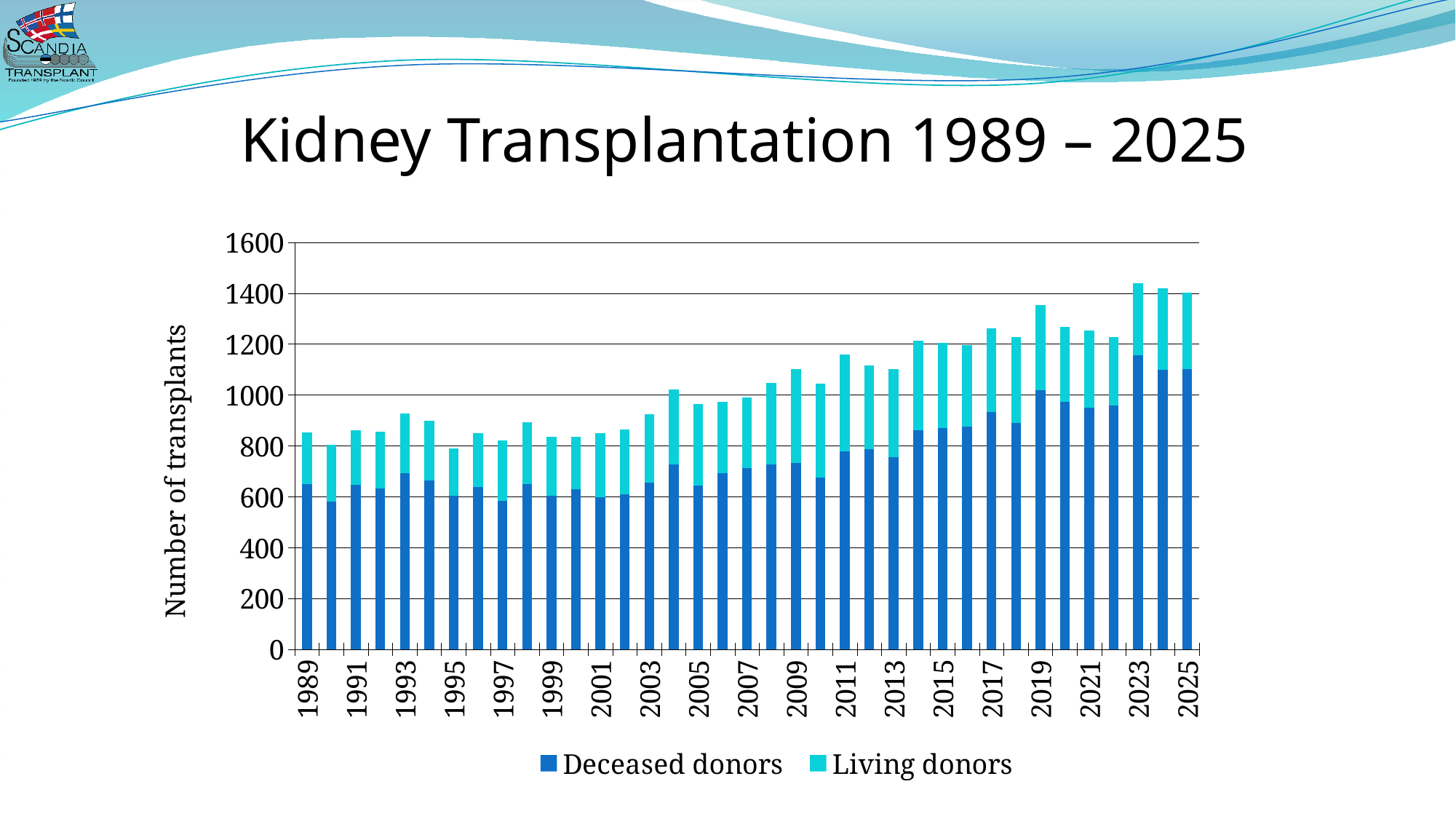
How many series does the legend list? 2 Is the Deceased donors value for 1995 greater or less than 800? less How many years (bars) are plotted in the chart? 37 What is the label of the vertical axis? Number of transplants Is the total number of transplants in 1989 greater or less than 1000? less Overall, do the total transplant numbers rise or fall from 1989 to 2025? rise Which year has the larger Deceased donors value, 1989 or 2023? 2023 Which two series are listed in the legend? Deceased donors and Living donors Is the Deceased donors value for 2023 greater or less than 1000? greater Which year has the larger total number of transplants, 2013 or 2019? 2019 What kind of chart is shown on the slide? Stacked bar chart